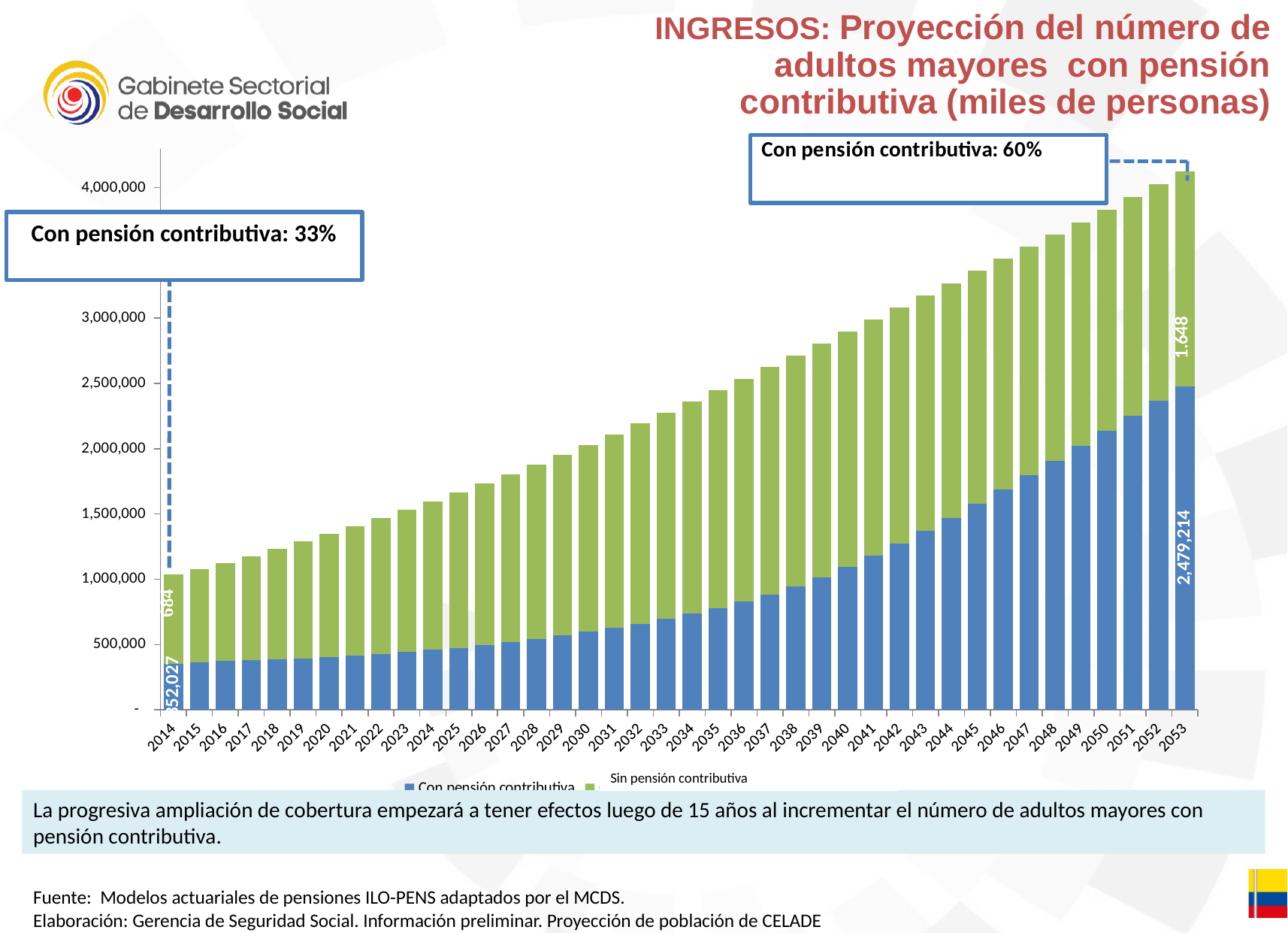
Which year has the highest total bar? 2053 How many years are shown along the x axis of the chart? 40 Is the total for 2040 greater or less than 3,000,000? less Do the total bar heights rise or fall from 2014 to 2053? Rise What kind of chart is shown on the slide? Stacked bar chart According to the callout box, what percentage has a contributory pension ('Con pensión contributiva') at the end of the projection (2053)? 60% Is the total for 2053 greater or less than 4,000,000? greater In 2053, which series is larger: 'Con pensión contributiva' or 'Sin pensión contributiva'? Con pensión contributiva How many series does the chart's legend list? 2 In 2014, which series is larger: 'Con pensión contributiva' or 'Sin pensión contributiva'? Sin pensión contributiva Which year has the lowest total bar? 2014 What is the value of 'Con pensión contributiva' for 2053? 2,479,214